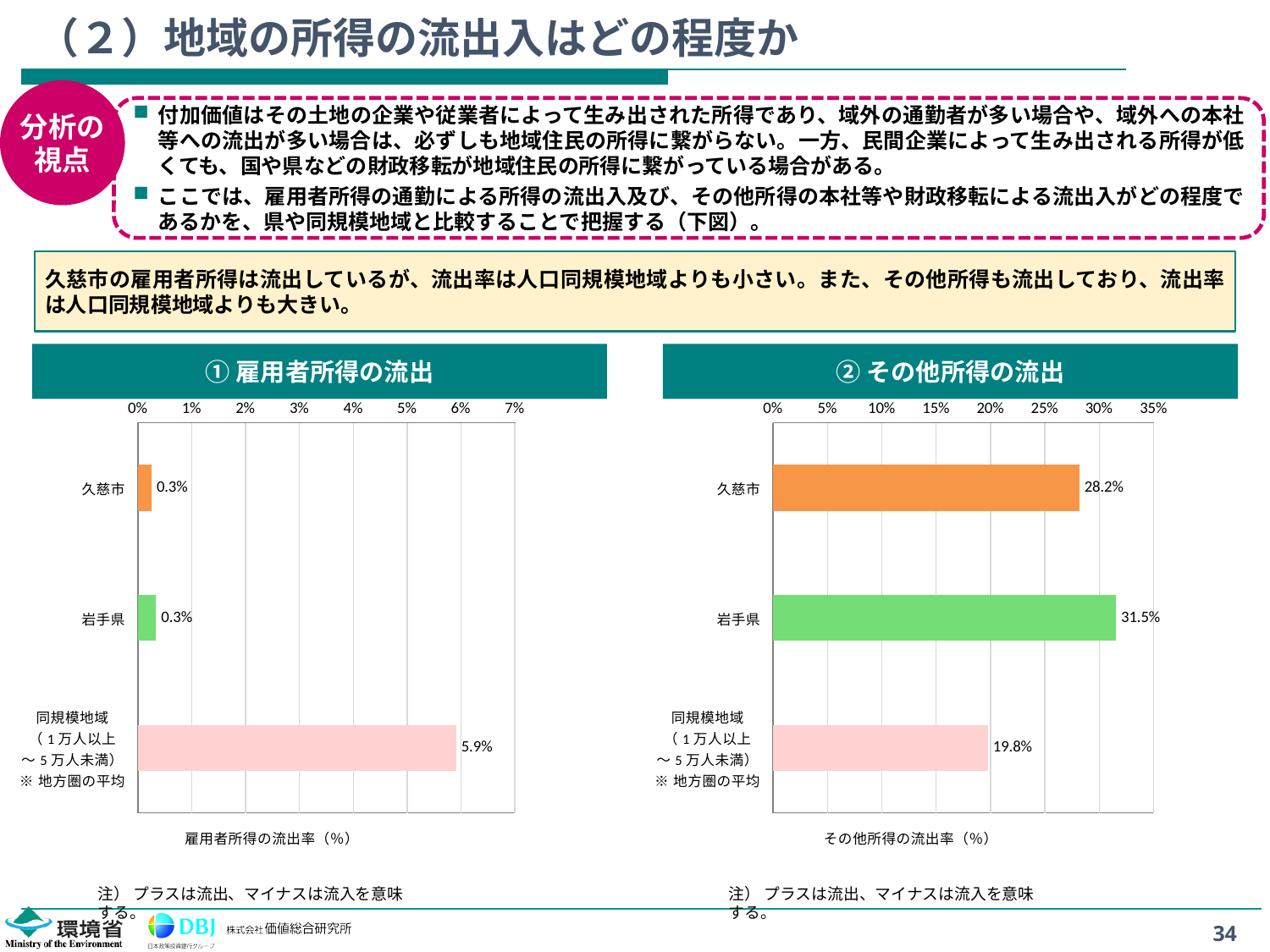
In the chart titled ② その他所得の流出, what is the value for 久慈市? 28.2% In the chart titled ① 雇用者所得の流出, what is the value for 同規模地域? 5.9% In the chart titled ② その他所得の流出, what is the value for 岩手県? 31.5% In the chart titled ① 雇用者所得の流出, what is the value for 久慈市? 0.3% How many categories are shown in the chart titled ① 雇用者所得の流出? 3 In the chart titled ① 雇用者所得の流出, what is the difference between the values for 同規模地域 and 久慈市? 5.6% In the chart titled ② その他所得の流出, is the value for 久慈市 larger or smaller than the value for 同規模地域? larger In the chart titled ② その他所得の流出, which category has the lowest value? 同規模地域 In the chart titled ① 雇用者所得の流出, which category has the highest value? 同規模地域 In the chart titled ② その他所得の流出, which category has the highest value? 岩手県 In the chart titled ② その他所得の流出, what is the value for 同規模地域? 19.8% In the chart titled ② その他所得の流出, what is the difference between the values for 岩手県 and 久慈市? 3.3%